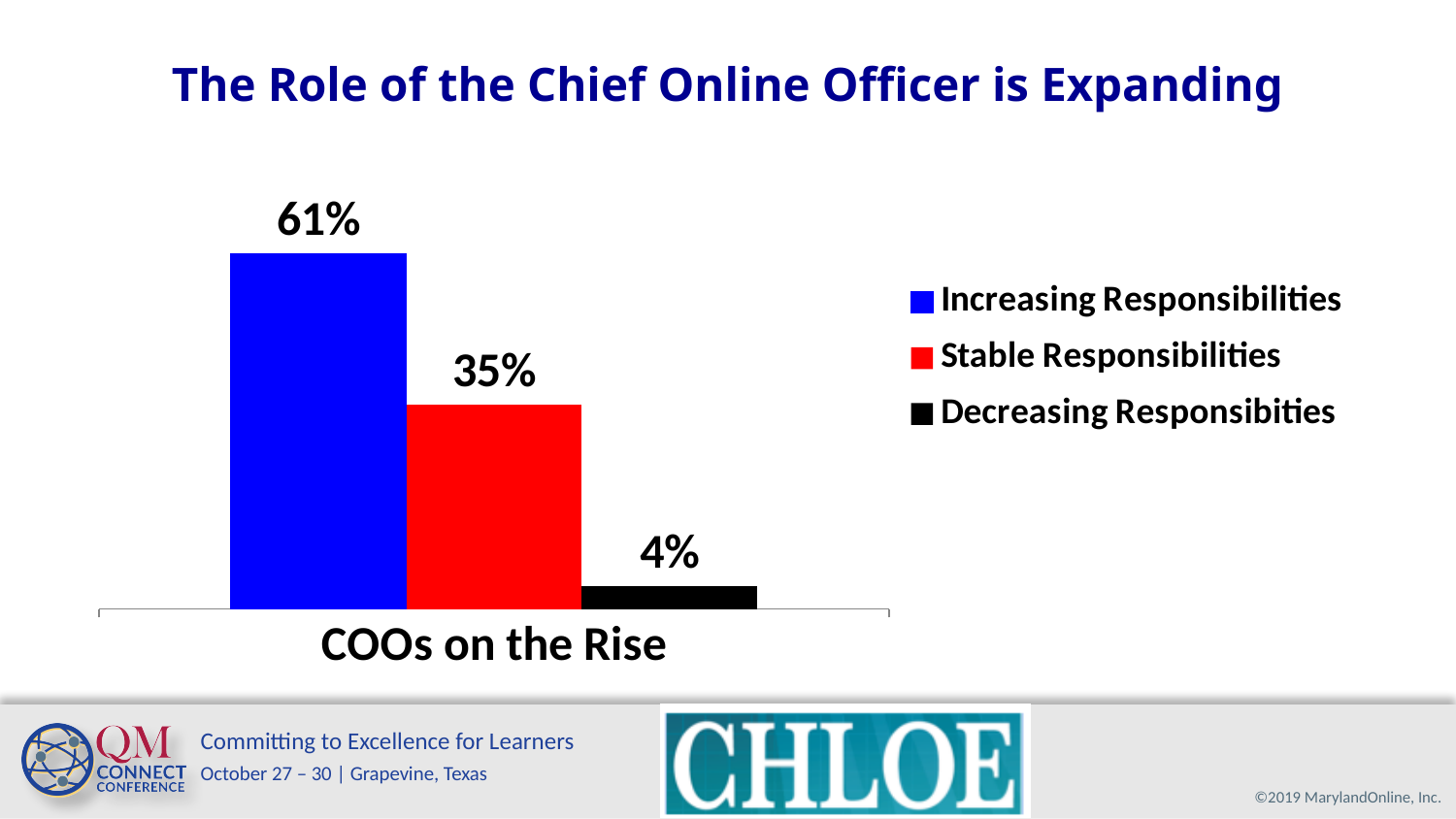
What is the value for Decreasing Responsibities? 4% What is the category label shown below the bars? COOs on the Rise What colour is the bar for Stable Responsibilities? Red Which series has the highest value? Increasing Responsibilities Which series has the lowest value? Decreasing Responsibities What is the difference between the Stable Responsibilities and Decreasing Responsibities values? 31% What is the difference between the Increasing Responsibilities and Stable Responsibilities values? 26% How many series does the legend list? 3 What kind of chart is shown on the slide? Bar chart What is the value for Stable Responsibilities? 35% Which is larger, Stable Responsibilities or Decreasing Responsibities? Stable Responsibilities What is the value for Increasing Responsibilities? 61%